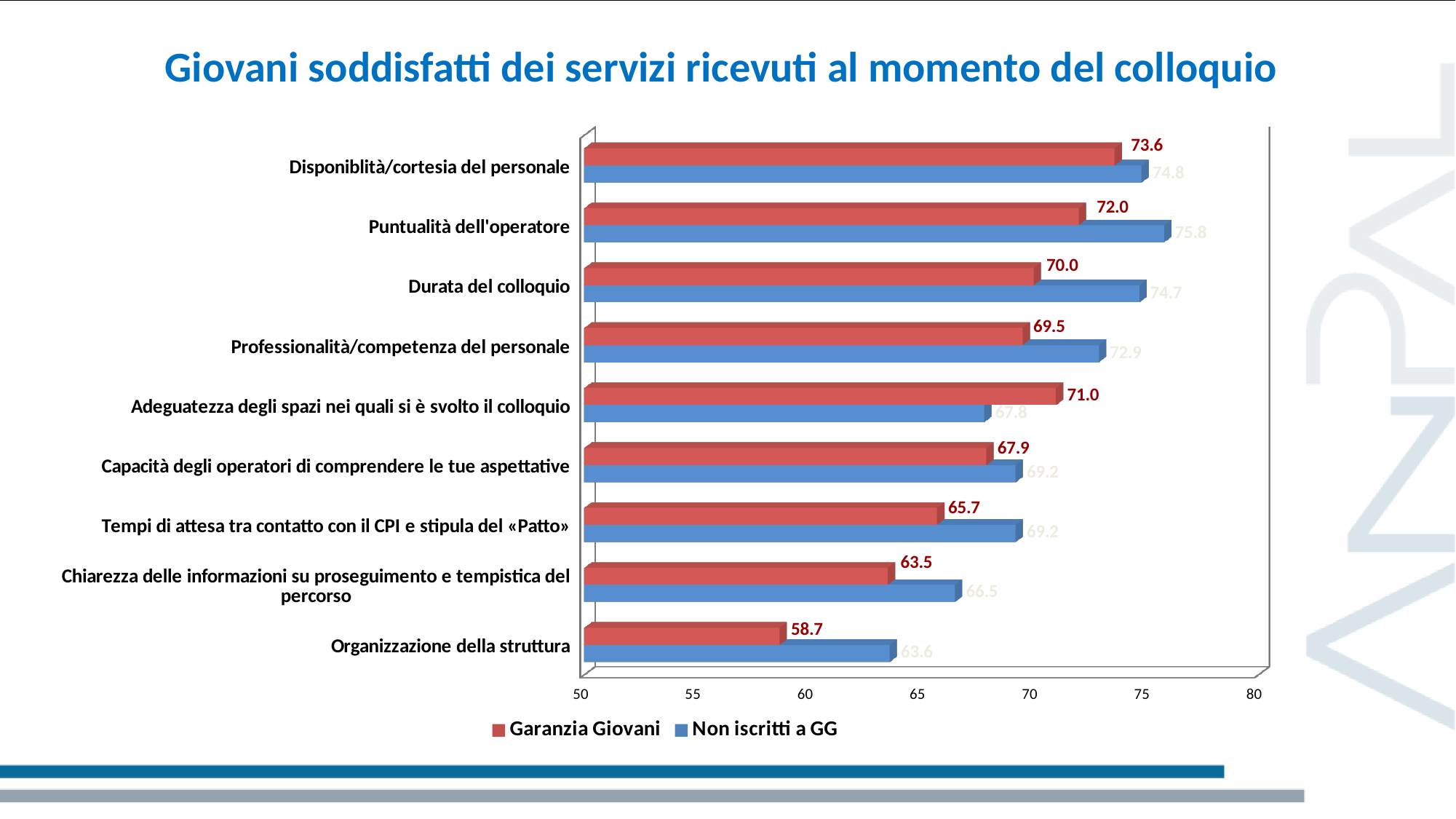
For Adeguatezza degli spazi nei quali si è svolto il colloquio, which series has the larger value, Garanzia Giovani or Non iscritti a GG? Garanzia Giovani Is the Garanzia Giovani value for Tempi di attesa tra contatto con il CPI e stipula del «Patto» greater or less than 70? less How many categories are shown on the chart? 9 What is the Garanzia Giovani value for Disponiblità/cortesia del personale? 73.6 Which category has the lowest Non iscritti a GG value? Organizzazione della struttura What is the Non iscritti a GG value for Puntualità dell'operatore? 75.8 What is the Garanzia Giovani value for Organizzazione della struttura? 58.7 How many series does the legend list? 2 What kind of chart is shown on the slide? Bar chart Which category has the highest Garanzia Giovani value? Disponiblità/cortesia del personale What is the title of the chart? Giovani soddisfatti dei servizi ricevuti al momento del colloquio What is the difference between the Non iscritti a GG and Garanzia Giovani values for Durata del colloquio? 4.7